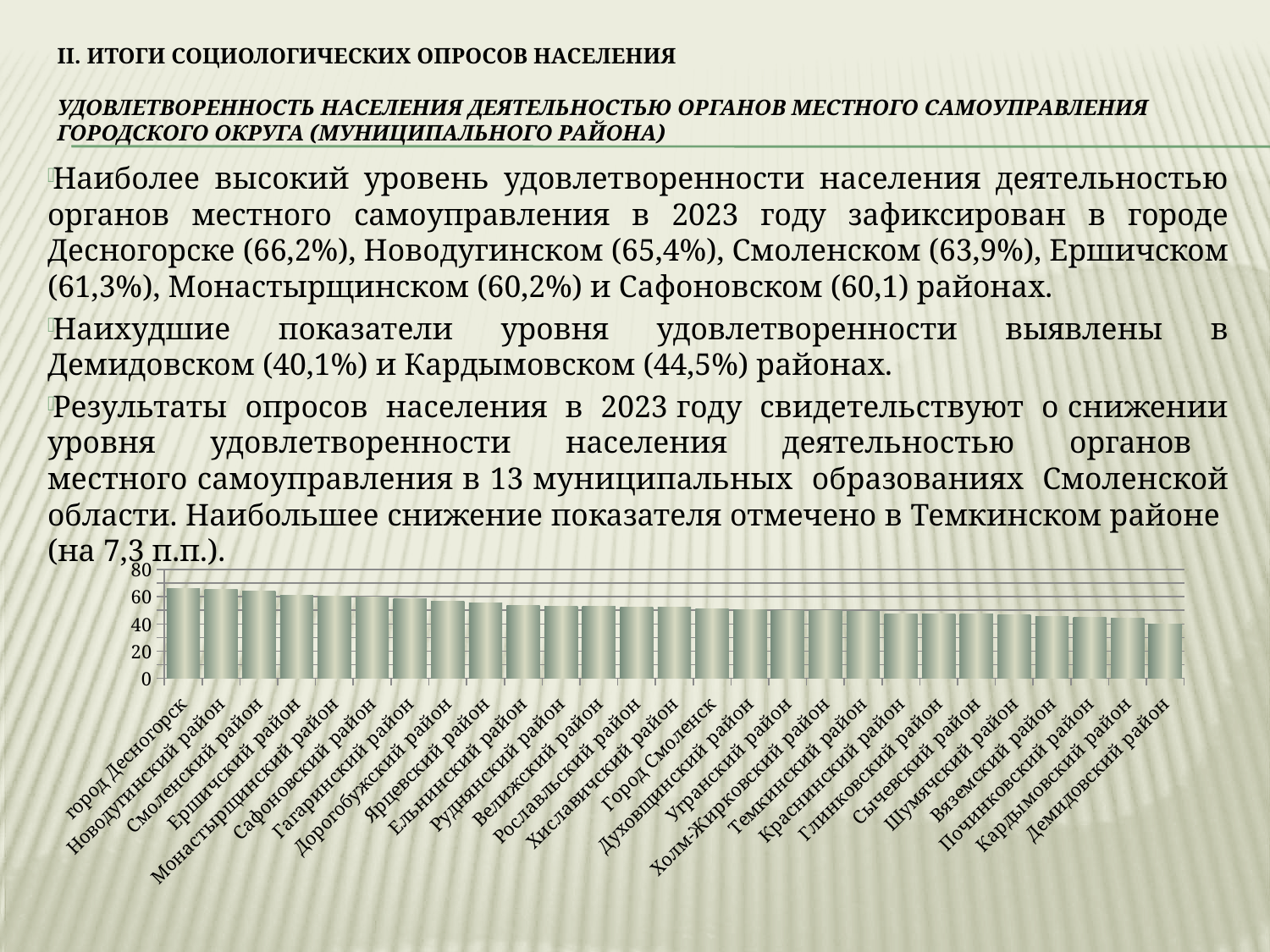
Which category has the lowest bar in the chart? Демидовский район What is the highest value shown on the vertical axis of the chart? 80 Do the bar values rise or fall moving from left to right along the x axis? fall Which category has the highest bar in the chart? город Десногорск Is the value for Гагаринский район greater or less than 40? greater Which is larger, the bar for Новодугинский район or the bar for Кардымовский район? Новодугинский район Is the value for город Десногорск greater or less than 60? greater Is the value for Город Смоленск greater or less than 60? less Which is larger, the bar for Вяземский район or the bar for Смоленский район? Смоленский район How many municipalities (categories) are shown on the x axis of the chart? 27 What kind of chart is shown at the bottom of the slide? bar chart